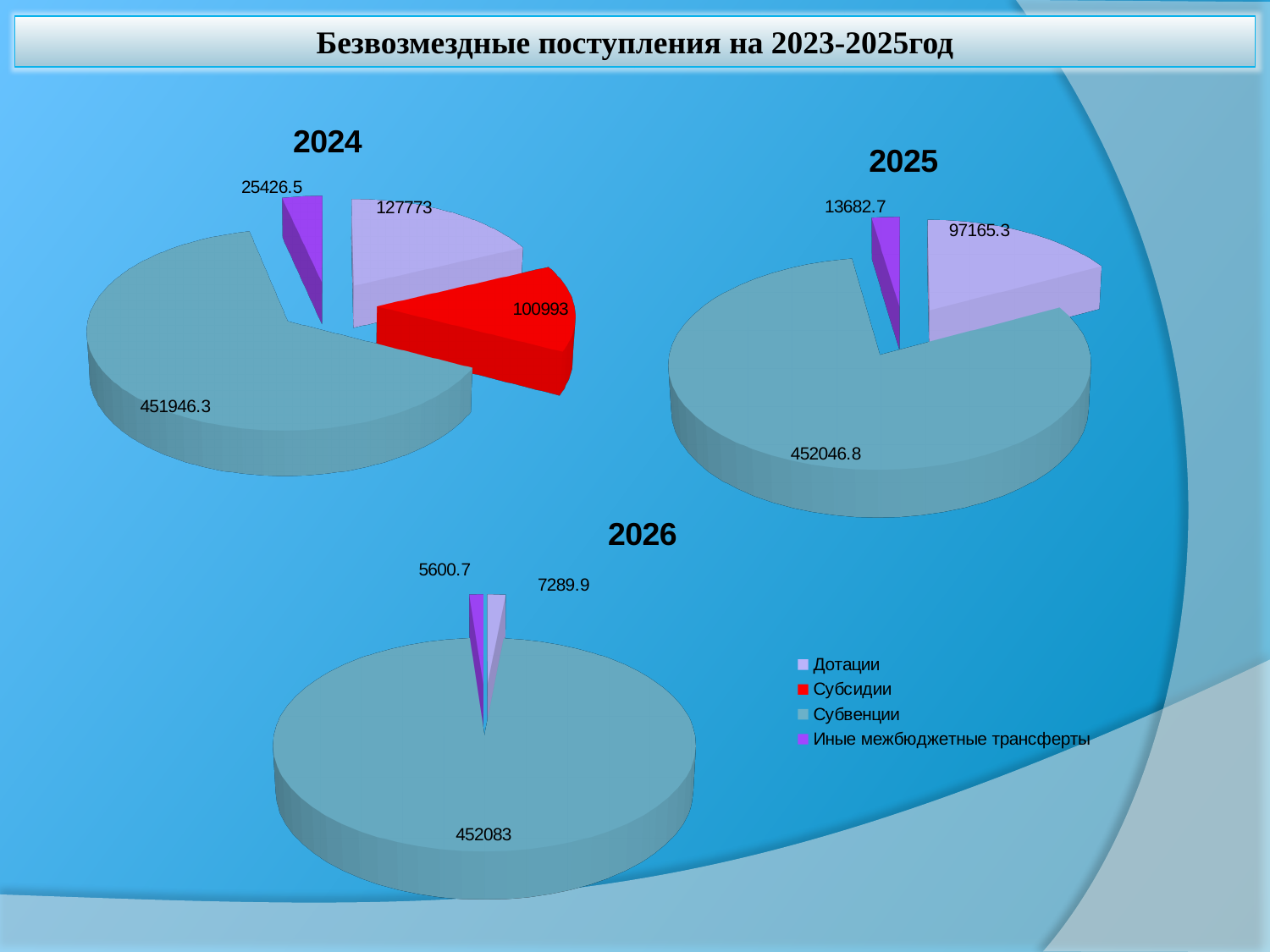
In the 2025 pie chart, which is larger: Дотации or Иные межбюджетные трансферты? Дотации In the 2024 pie chart, what is the value for Субсидии? 100993 What type of chart is used for the 2026 data? Pie chart In the 2024 pie chart, what is the value for Субвенции? 451946.3 In the 2026 pie chart, what is the value for Иные межбюджетные трансферты? 5600.7 How many slices does the 2024 pie chart have? 4 In the 2024 pie chart, what is the difference between the values for Дотации and Субсидии? 26780 How many entries does the legend list? 4 In the 2024 pie chart, which category has the smallest slice? Иные межбюджетные трансферты In the 2025 pie chart, what is the value for Дотации? 97165.3 In the 2026 pie chart, what is the difference between the values for Дотации and Иные межбюджетные трансферты? 1689.2 In the 2025 pie chart, which category has the largest slice? Субвенции